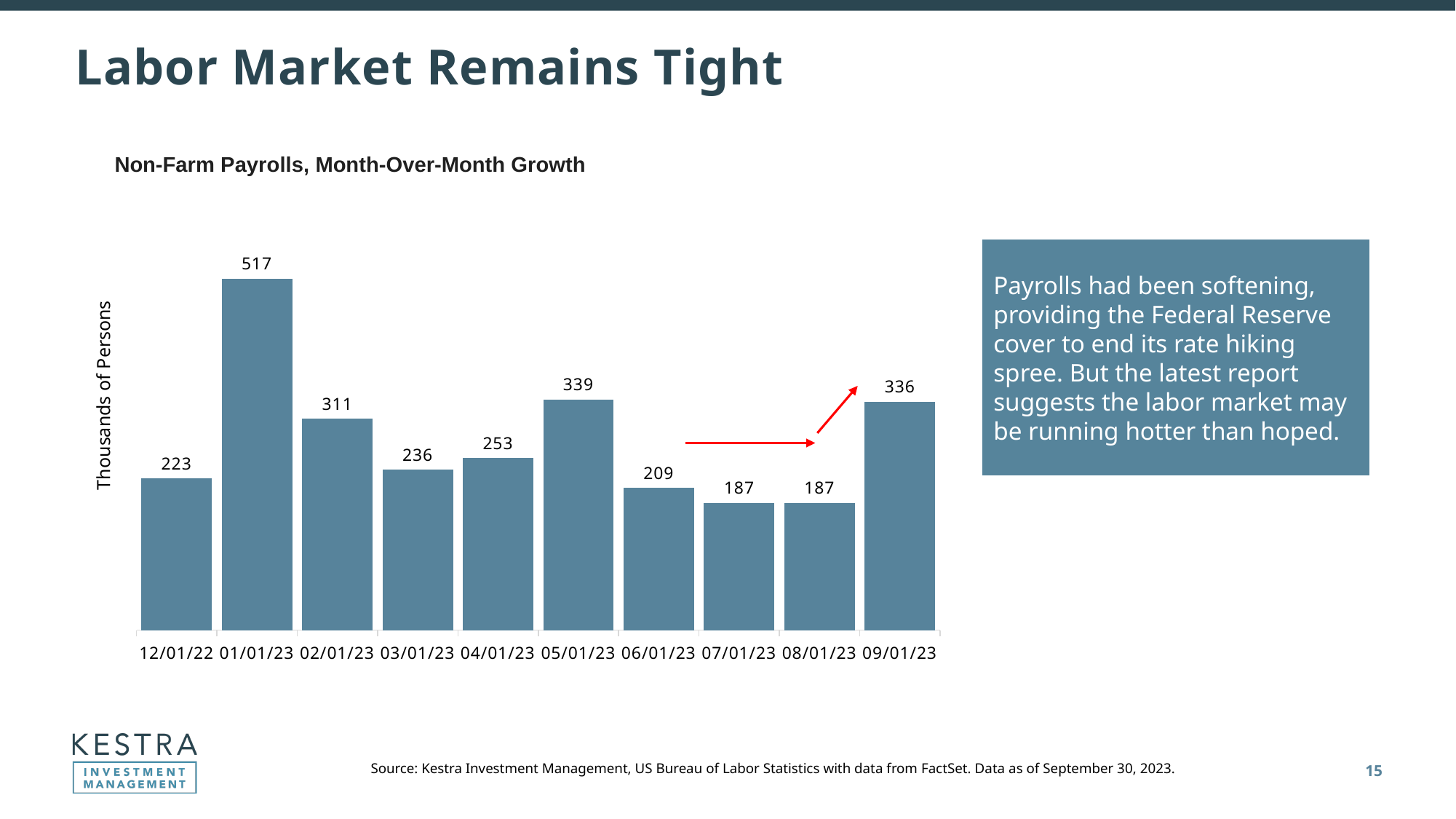
What is the label on the vertical axis? Thousands of Persons What is the value for 09/01/23? 336 Do the values rise or fall from 05/01/23 to 07/01/23? Fall What is the lowest value shown on the chart? 187 Which is larger, the value for 05/01/23 or the value for 09/01/23? 05/01/23 How many months are shown on the chart? 10 What is the difference between the values for 01/01/23 and 02/01/23? 206 What kind of chart is shown? Bar chart What is the value for 12/01/22? 223 What is the value for 01/01/23? 517 What is the difference between the values for 09/01/23 and 08/01/23? 149 Which month has the highest value? 01/01/23